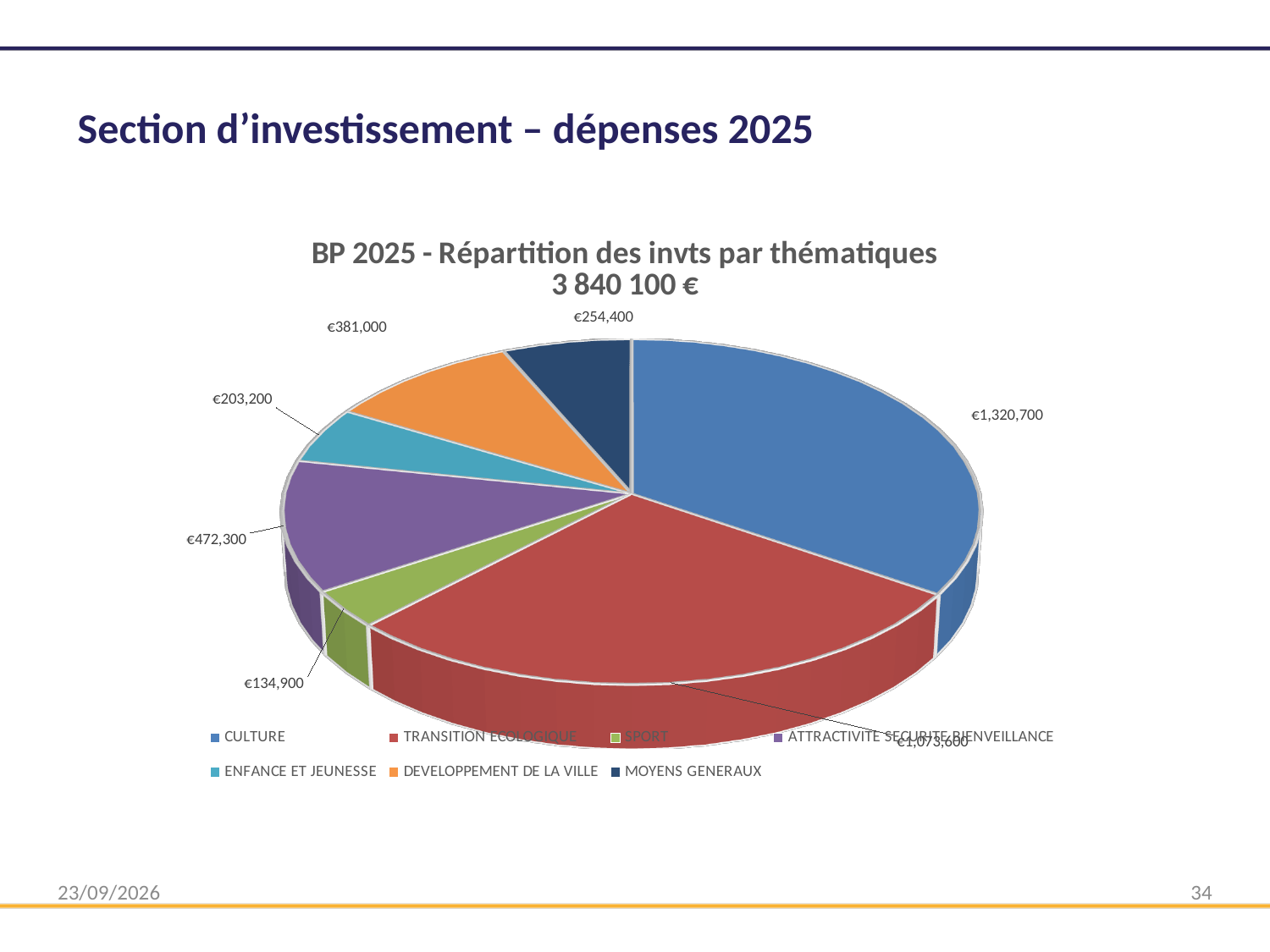
What is the value for DEVELOPPEMENT DE LA VILLE? €381,000 What total amount is stated in the chart title? 3 840 100 € Which category has the smallest slice of the pie? SPORT What is the value for MOYENS GENERAUX? €254,400 Which category has the largest slice of the pie? CULTURE How many slices does the pie chart have? 7 What is the value for CULTURE? €1,320,700 What is the difference between ATTRACTIVITE SECURITE BIENVEILLANCE and ENFANCE ET JEUNESSE? €269,100 Which is larger, DEVELOPPEMENT DE LA VILLE or MOYENS GENERAUX? DEVELOPPEMENT DE LA VILLE What kind of chart is shown on the slide? Pie chart What is the value for ENFANCE ET JEUNESSE? €203,200 What is the value for SPORT? €134,900